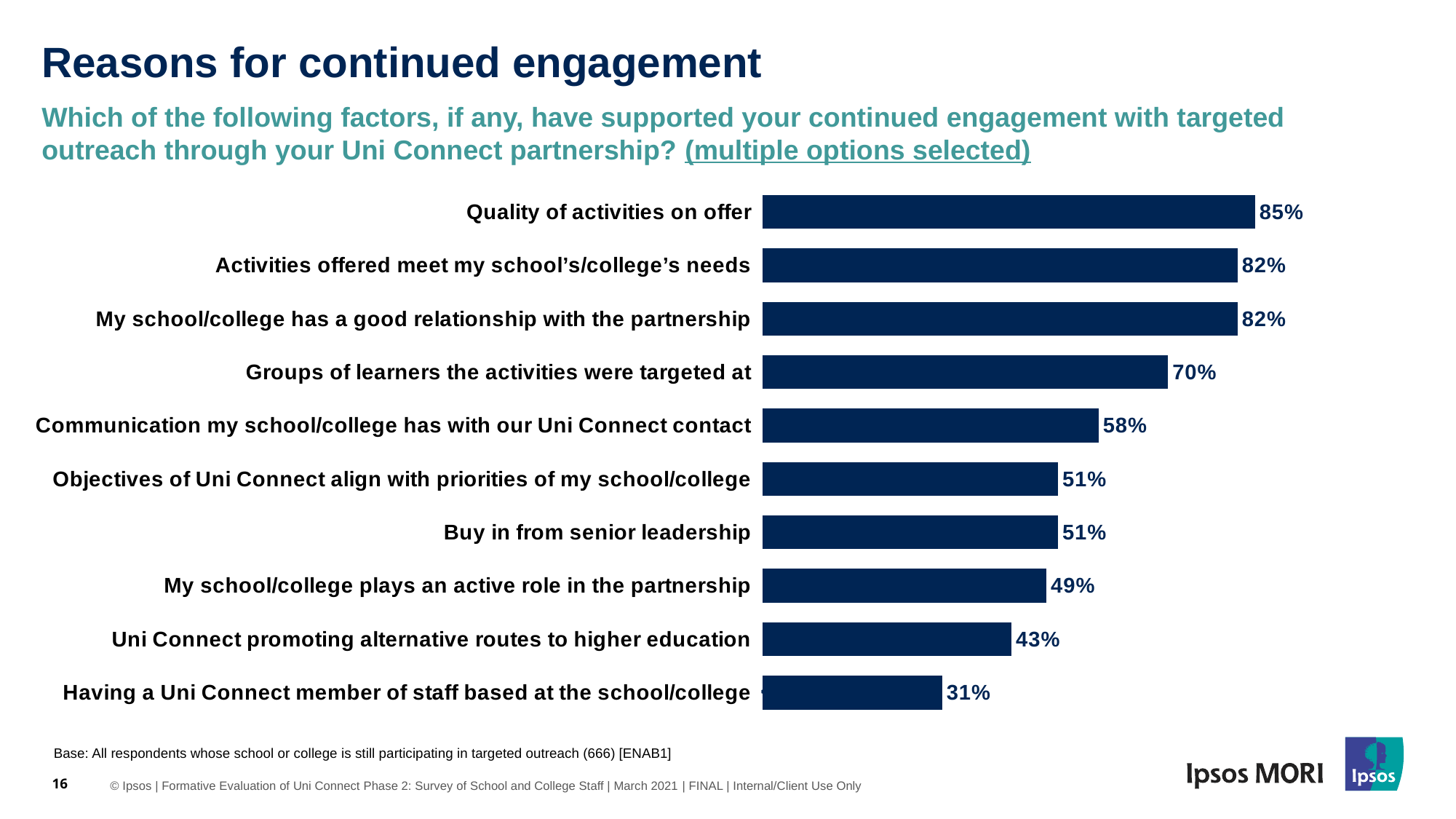
Which is larger: the value for 'Buy in from senior leadership' or the value for 'My school/college plays an active role in the partnership'? Buy in from senior leadership What is the difference between 'Groups of learners the activities were targeted at' and 'Communication my school/college has with our Uni Connect contact'? 12 percentage points How many factors (bars) are shown in the chart? 10 What is the value for 'Uni Connect promoting alternative routes to higher education'? 43% What percentage of respondents selected 'Quality of activities on offer' as a factor supporting continued engagement? 85% What is the value shown for 'Groups of learners the activities were targeted at'? 70% What type of chart is used on this slide? Bar chart What is the difference in percentage points between 'Quality of activities on offer' and 'Having a Uni Connect member of staff based at the school/college'? 54 percentage points Which factor has the lowest percentage in the chart? Having a Uni Connect member of staff based at the school/college Which factor has the highest percentage in the chart? Quality of activities on offer What is the base size of respondents stated below the chart? 666 What percentage is shown for 'Communication my school/college has with our Uni Connect contact'? 58%